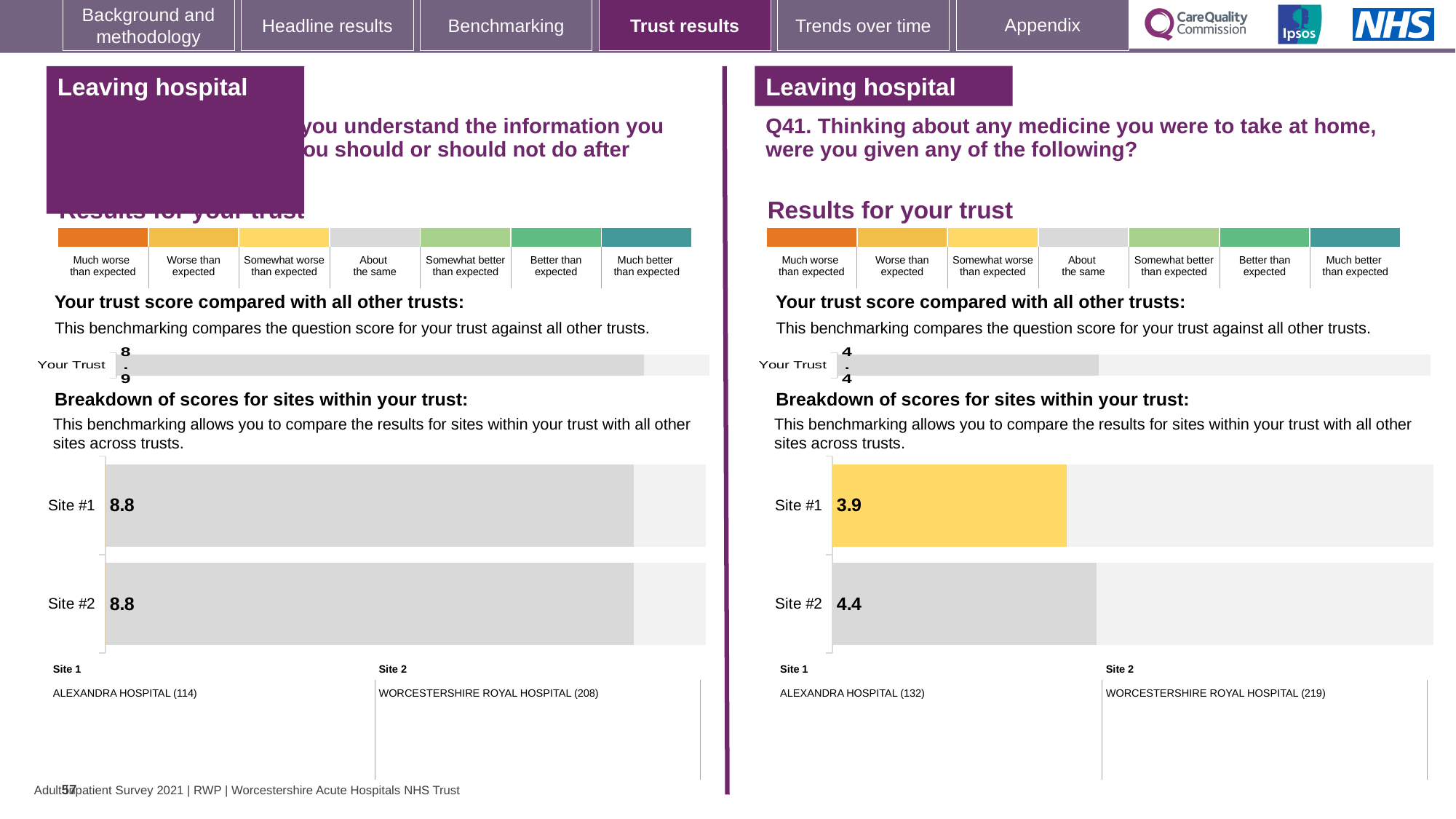
On the right-hand (Q41) site breakdown chart, what colour is the bar for Site #1? Yellow On the right-hand (Q41) site breakdown chart, what is the score for Site #2? 4.4 What type of chart is used for the site breakdown on the right-hand (Q41) side of the slide? Bar chart On the left-hand site breakdown chart, how many sites are shown? 2 On the right-hand (Q41) site breakdown chart, what is the difference between the scores for Site #2 and Site #1? 0.5 On the right-hand (Q41) site breakdown chart, which site has the higher score? Site #2 On the right-hand (Q41) site breakdown chart, what is the score for Site #1? 3.9 On the right-hand (Q41) site breakdown chart, which site has the lowest score? Site #1 On the left-hand 'Your trust score compared with all other trusts' chart, what is the score for Your Trust? 8.9 On the left-hand site breakdown chart, what is the score for Site #2? 8.8 On the left-hand site breakdown chart, what is the score for Site #1? 8.8 On the right-hand (Q41) 'Your trust score compared with all other trusts' chart, what is the score for Your Trust? 4.4